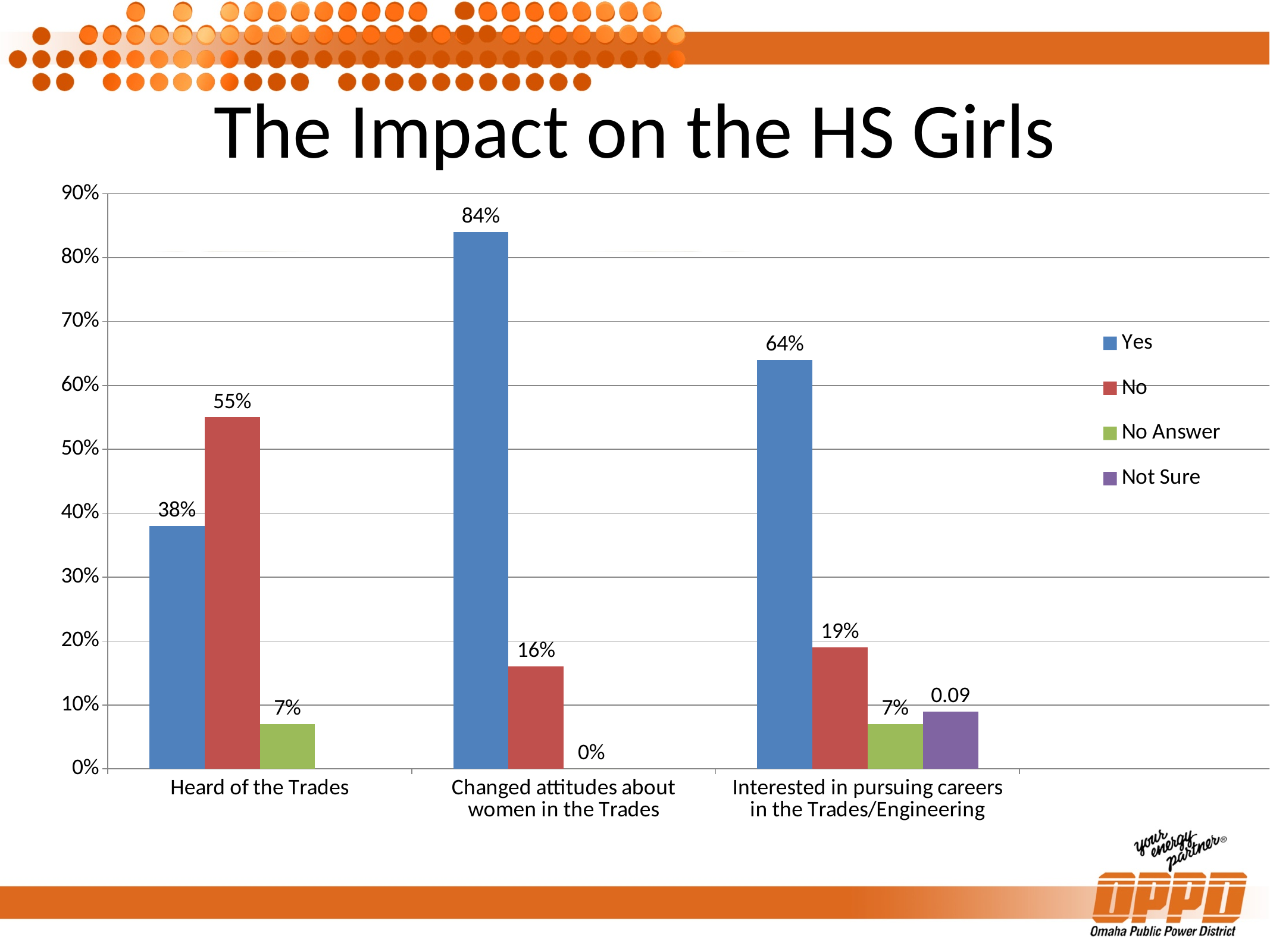
What is the difference between the 'Yes' and 'No' values for 'Heard of the Trades'? 17% What kind of chart is shown on the slide? Bar chart Which category has the highest 'Yes' value? Changed attitudes about women in the Trades What is the 'No' value for 'Changed attitudes about women in the Trades'? 16% Which category has the lowest 'No' value? Changed attitudes about women in the Trades What is the title of the slide? The Impact on the HS Girls How many categories are shown on the x axis? 3 What is the 'Not Sure' value for 'Interested in pursuing careers in the Trades/Engineering'? 0.09 What is the 'No Answer' value for 'Changed attitudes about women in the Trades'? 0% How many series does the legend list? 4 What is the 'Yes' value for 'Heard of the Trades'? 38% Which is larger for 'Interested in pursuing careers in the Trades/Engineering': the 'Yes' value or the 'No' value? Yes